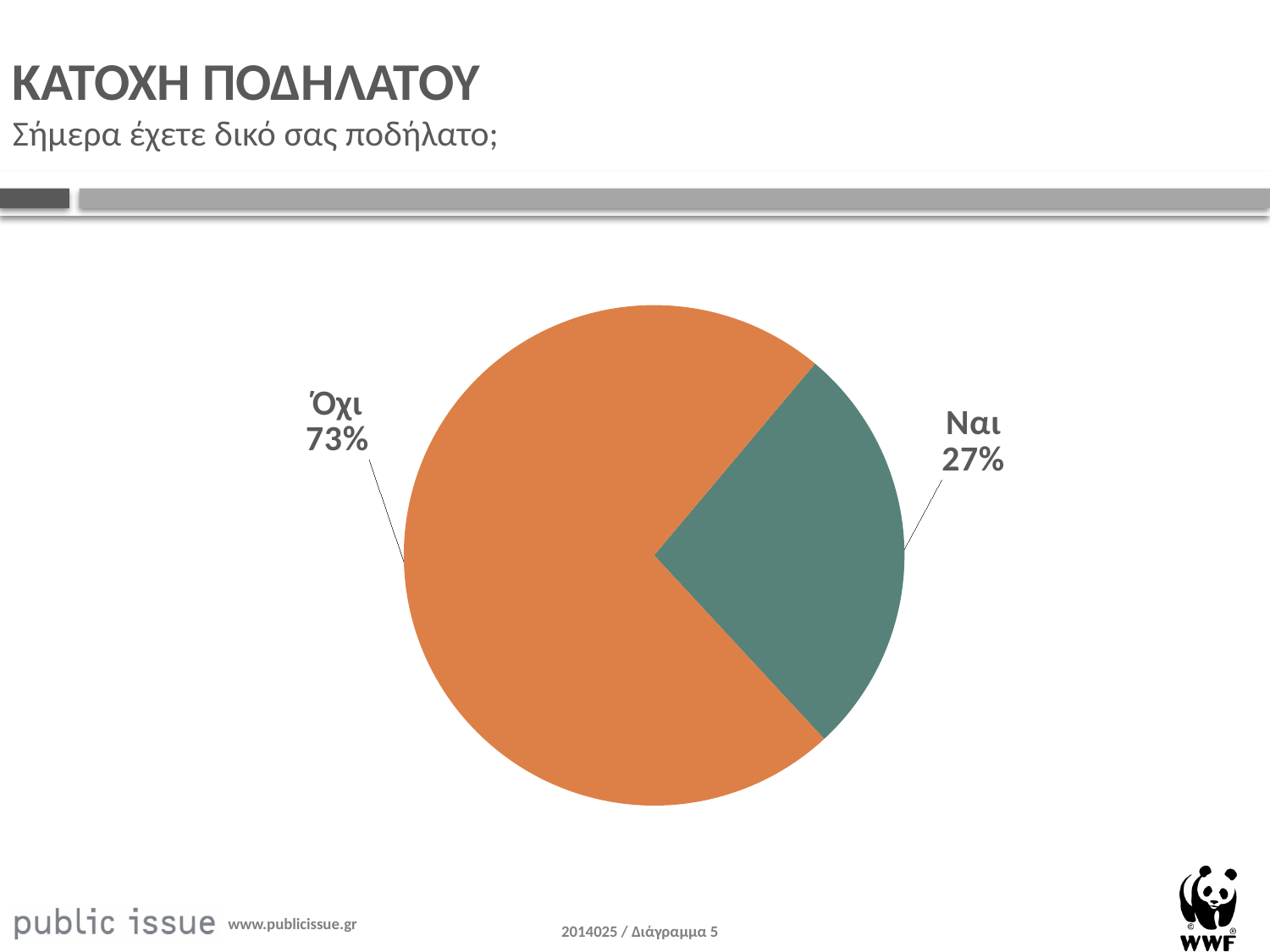
What kind of chart is shown on the slide? Pie chart What percentage of respondents answered Ναι? 27% How many slices does the pie chart have? 2 What is the difference in percentage points between Όχι and Ναι? 46 Which is larger, the share for Ναι or the share for Όχι? Όχι Which slice of the pie is the largest? Όχι What is the title of the chart on the slide? ΚΑΤΟΧΗ ΠΟΔΗΛΑΤΟΥ What colour is the Όχι slice of the pie? Orange What percentage of respondents answered Όχι? 73% What share of the pie does the Ναι slice represent? 27% Which slice of the pie is the smallest? Ναι